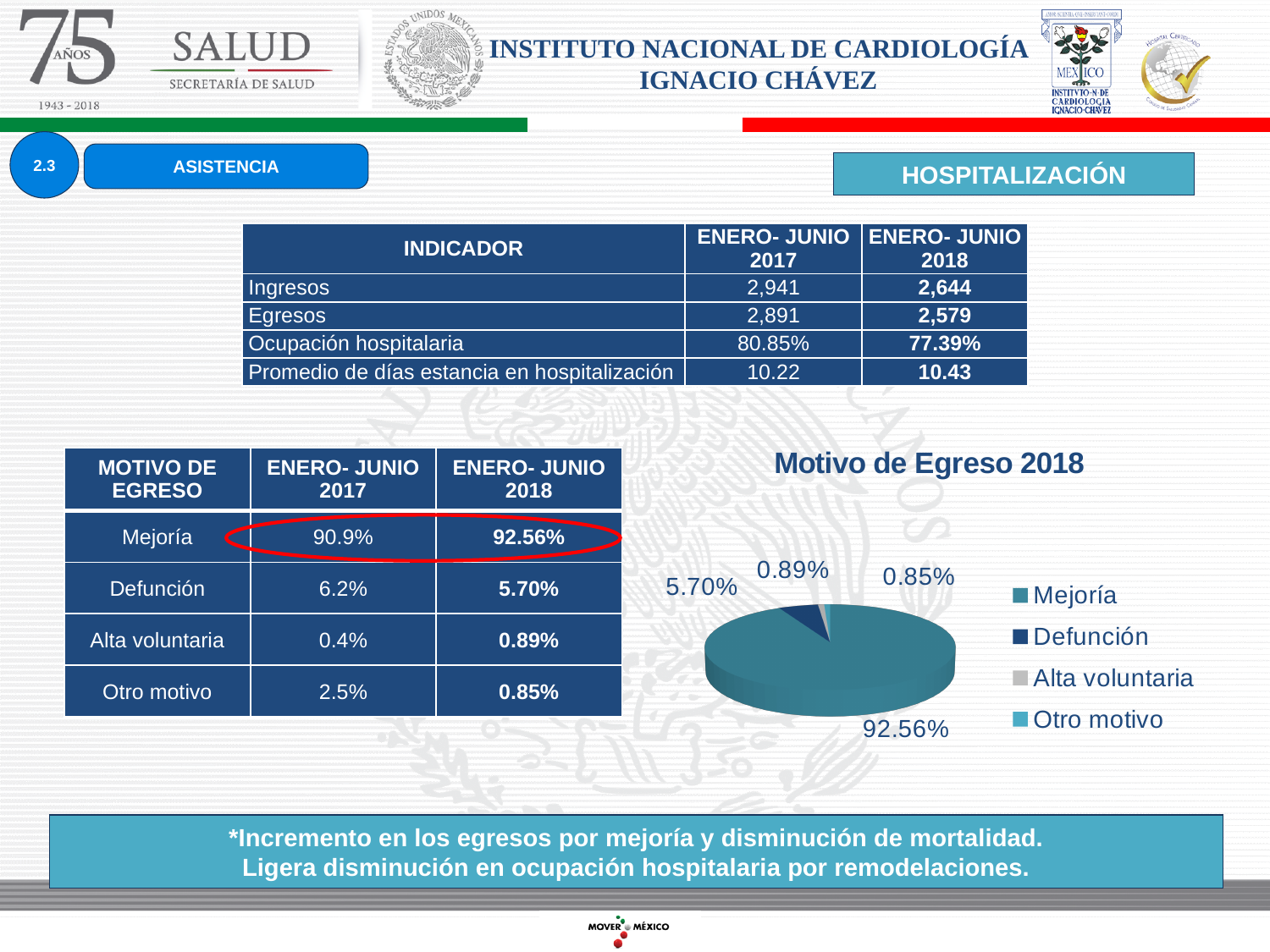
In the "Motivo de Egreso 2018" pie chart, what is the value for Otro motivo? 0.85% In the "Motivo de Egreso 2018" pie chart, which is larger: Defunción or Alta voluntaria? Defunción In the "Motivo de Egreso 2018" pie chart, what is the difference between the Mejoría and Defunción values? 86.86% What type of chart is shown under the title "Motivo de Egreso 2018"? pie chart Which category has the largest slice in the "Motivo de Egreso 2018" pie chart? Mejoría How many entries does the legend of the "Motivo de Egreso 2018" pie chart list? 4 Which category has the smallest slice in the "Motivo de Egreso 2018" pie chart? Otro motivo In the "Motivo de Egreso 2018" pie chart, what is the value for Alta voluntaria? 0.89% How many slices does the "Motivo de Egreso 2018" pie chart have? 4 In the "Motivo de Egreso 2018" pie chart, what is the value for Mejoría? 92.56% In the "Motivo de Egreso 2018" pie chart, what is the difference between the Alta voluntaria and Otro motivo values? 0.04% In the "Motivo de Egreso 2018" pie chart, what is the value for Defunción? 5.70%